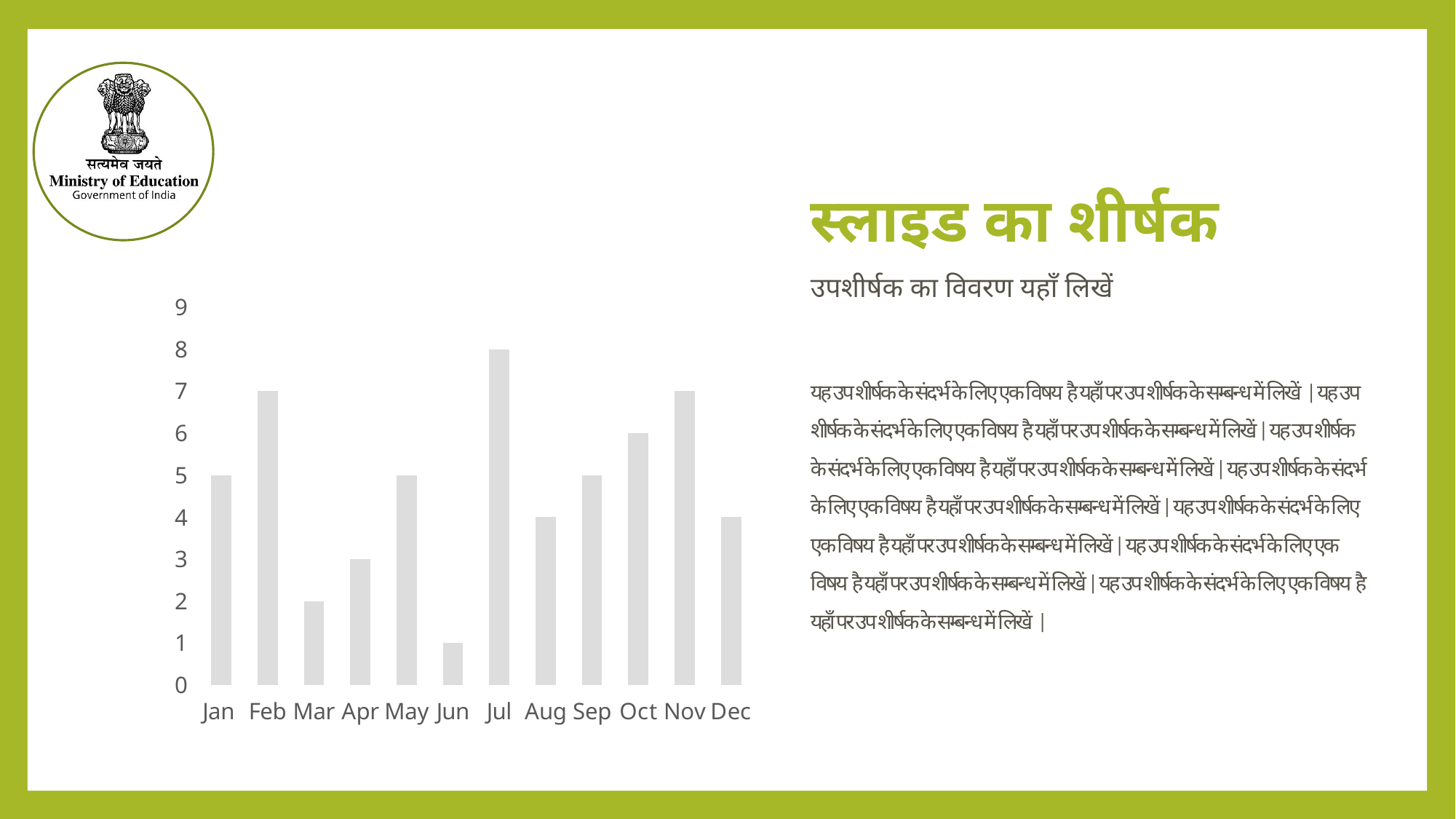
What is the value for Oct in the bar chart? 6 Do the bars rise or fall from Mar to May? rise Is the value for Nov greater or less than 5? greater Which month has the lowest bar in the chart? Jun What is the value for Jul in the bar chart? 8 What is the value for Jun in the bar chart? 1 What is the difference between the values for Jul and Mar? 6 What is the highest value shown on the y axis of the chart? 9 What kind of chart is shown on the slide? bar chart How many months are shown on the x axis of the bar chart? 12 Which month has the highest bar in the chart? Jul Which is larger, the value for Feb or the value for Apr? Feb